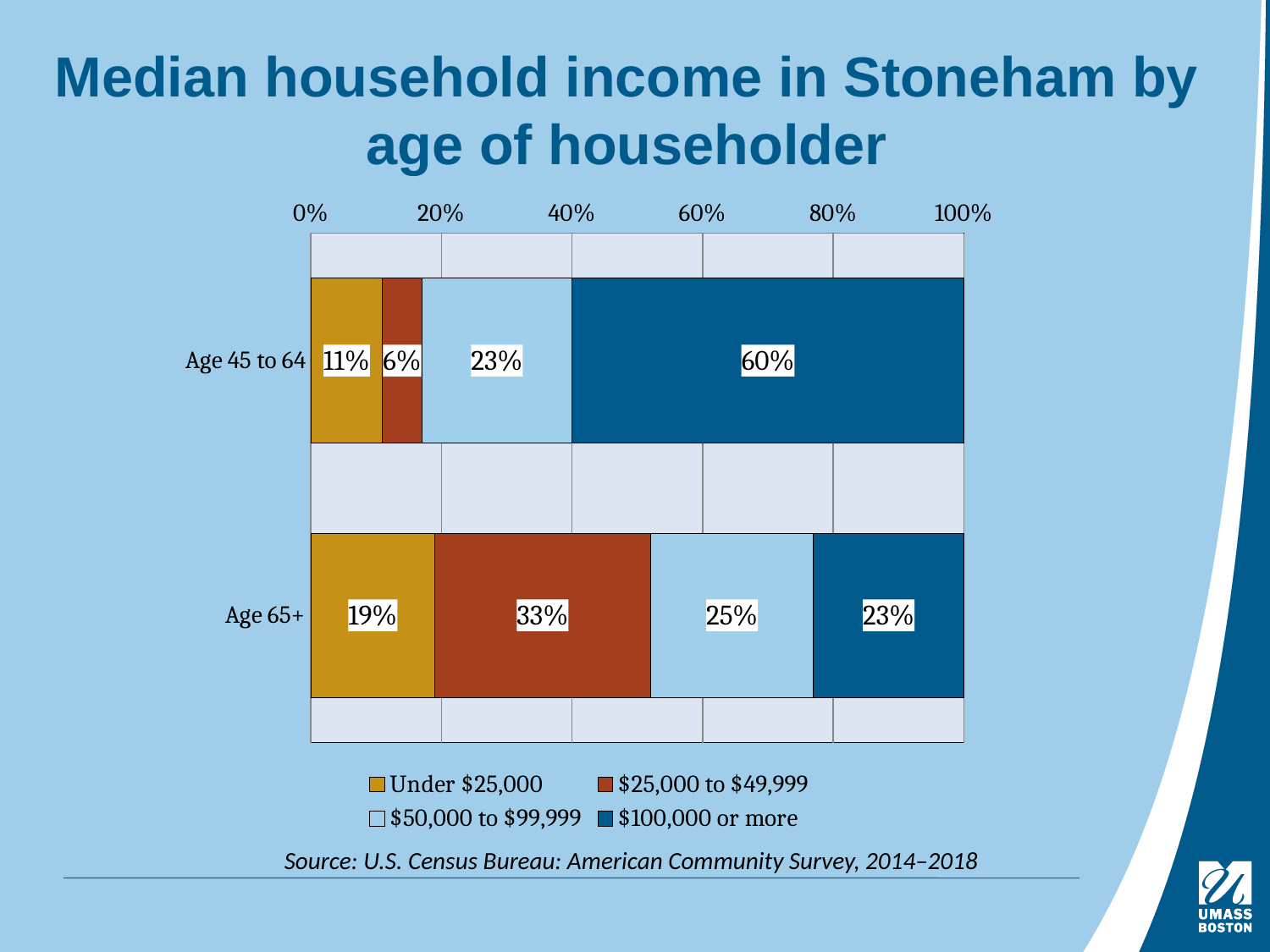
How many age groups are shown in the chart? 2 What share of Age 65+ householders have a household income of $25,000 to $49,999? 33% What share of Age 65+ householders have a household income under $25,000? 19% Which income category is the largest for the Age 45 to 64 group? $100,000 or more What type of chart is shown on the slide? Stacked bar chart Which age group has a larger share of householders with income under $25,000? Age 65+ How many income categories does the legend list? 4 What share of Age 45 to 64 householders have a household income of $100,000 or more? 60% Which income category is the largest for the Age 65+ group? $25,000 to $49,999 What is the difference between the $100,000 or more share for Age 45 to 64 and for Age 65+? 37 percentage points What share of Age 45 to 64 householders have a household income of $25,000 to $49,999? 6% Which income category is the smallest for the Age 45 to 64 group? $25,000 to $49,999